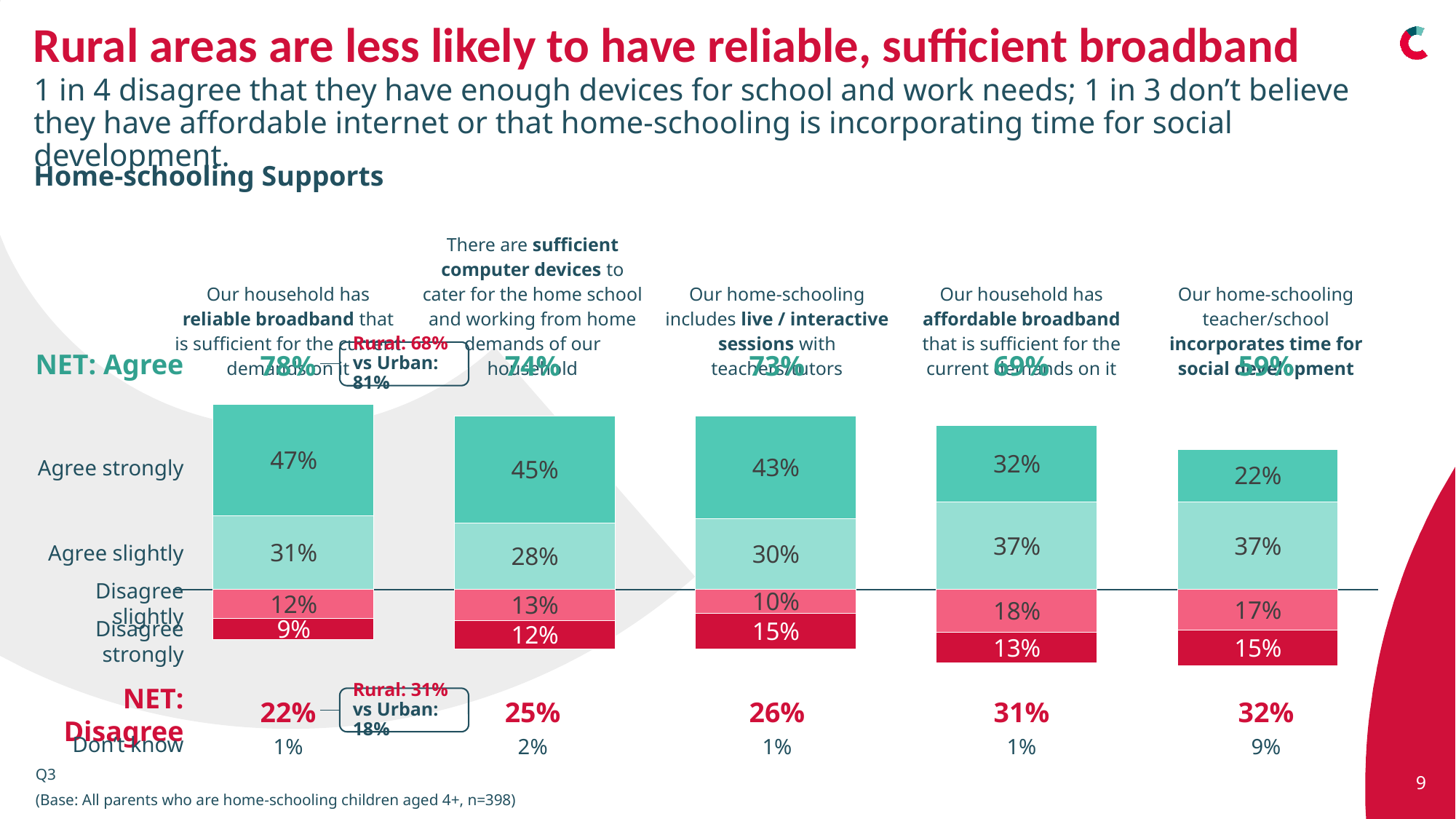
How many statements are shown as bars in the chart? 5 What is the 'Agree slightly' value for the statement that home-schooling incorporates time for social development? 37% Which statement has the highest 'Agree strongly' percentage? Our household has reliable broadband that is sufficient for the current demands on it According to the callout, what is the NET: Agree figure for reliable broadband among rural respondents versus urban respondents? Rural: 68% vs Urban: 81% What is the NET: Agree figure for the statement about sufficient computer devices? 74% What is the difference between the NET: Disagree figures for the affordable broadband statement and the reliable broadband statement? 9 percentage points How many response categories are stacked in each bar (excluding Don't know)? 4 What type of chart is used on this slide? Stacked bar chart What percentage of parents agree strongly that their household has reliable broadband sufficient for current demands? 47% What is the 'Don't know' percentage for the statement about home-schooling incorporating time for social development? 9% Which statement has the lowest NET: Agree figure? Our home-schooling teacher/school incorporates time for social development Which is larger: the 'Disagree strongly' value for live / interactive sessions or for sufficient computer devices? Live / interactive sessions (15%)